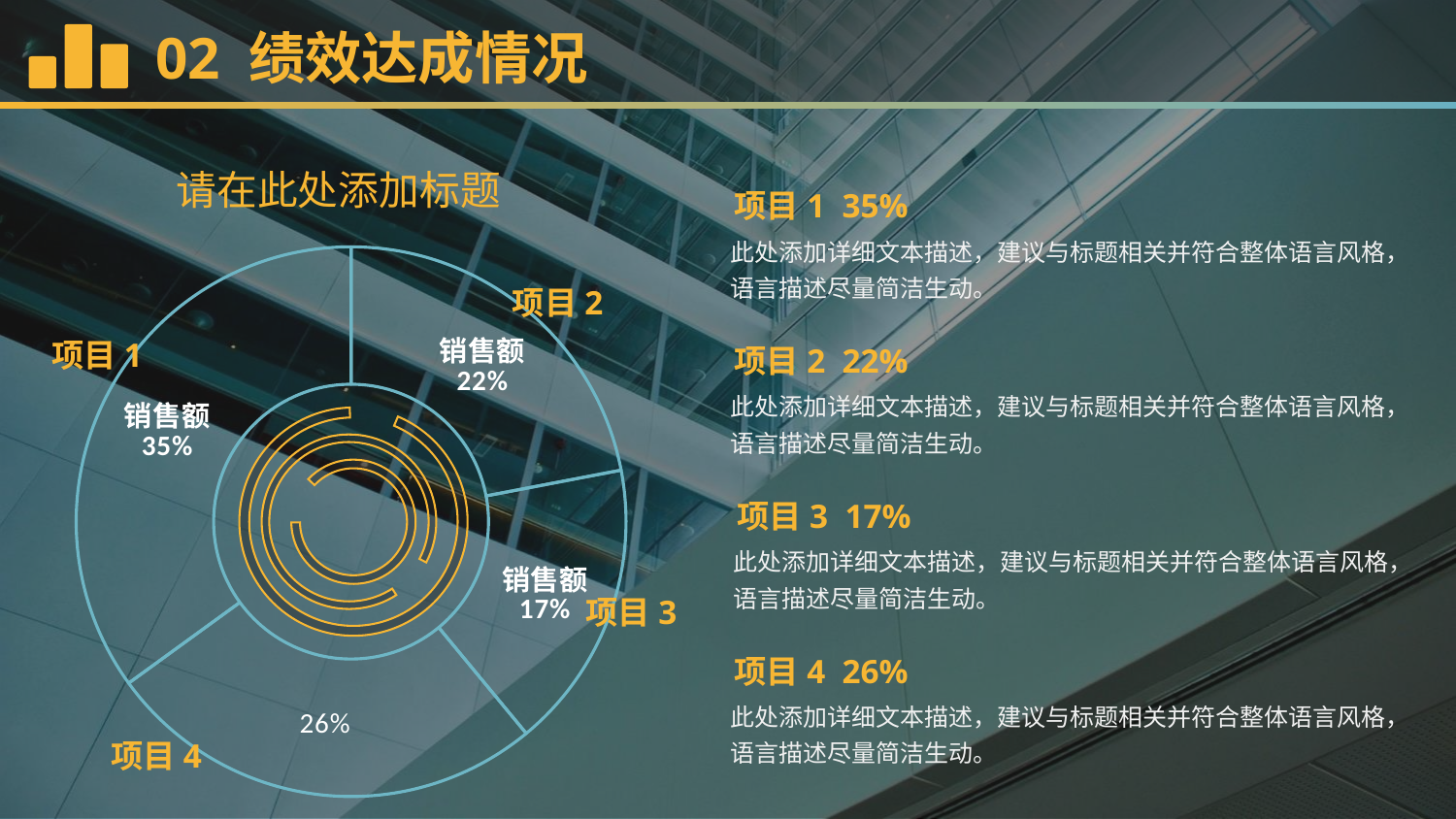
What is the difference between the values for 项目 1 and 项目 3? 18% What is the value for 项目 4 in the chart? 26% Which category has the largest share in the chart? 项目 1 What is the value for 项目 1 in the chart? 35% Which category has the smallest share in the chart? 项目 3 What kind of chart is shown on the slide? Doughnut chart What is the name of the data series shown in the chart? 销售额 How many categories are shown in the chart? 4 What is the value for 项目 2 in the chart? 22% What is the title of the chart? 请在此处添加标题 What is the value for 项目 3 in the chart? 17% Which is larger, the value for 项目 2 or the value for 项目 4? 项目 4